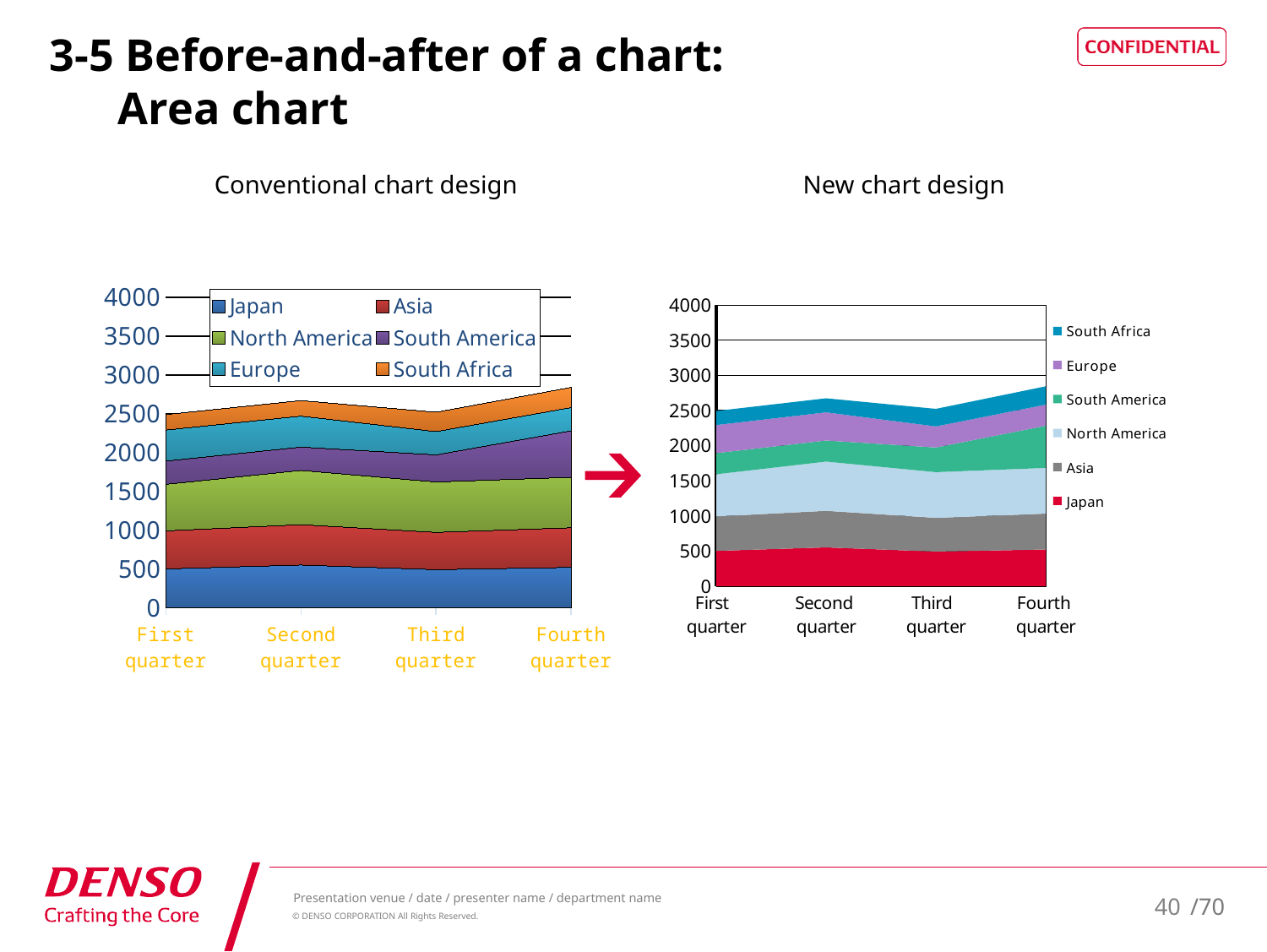
In the 'New chart design' chart, which series is listed at the bottom of the legend? Japan In the 'New chart design' chart, is the stacked total for Fourth quarter larger or smaller than the stacked total for Third quarter? Larger In the 'New chart design' chart, is the stacked total for Fourth quarter greater or less than 2500? greater In the 'New chart design' chart, how many quarters are shown on the x axis? 4 In the 'New chart design' chart, which quarter has the highest stacked total? Fourth quarter In the 'New chart design' chart, what colour is the Japan series? Red In the 'New chart design' chart, is the stacked total for Fourth quarter greater or less than 3000? less In the 'Conventional chart design' chart, how many series does the legend list? 6 In the 'Conventional chart design' chart, does the stacked total rise or fall from Third quarter to Fourth quarter? Rise What kind of chart is the 'Conventional chart design' chart? Stacked area chart What kind of chart is the 'New chart design' chart? Stacked area chart In the 'New chart design' chart, how many series does the legend list? 6